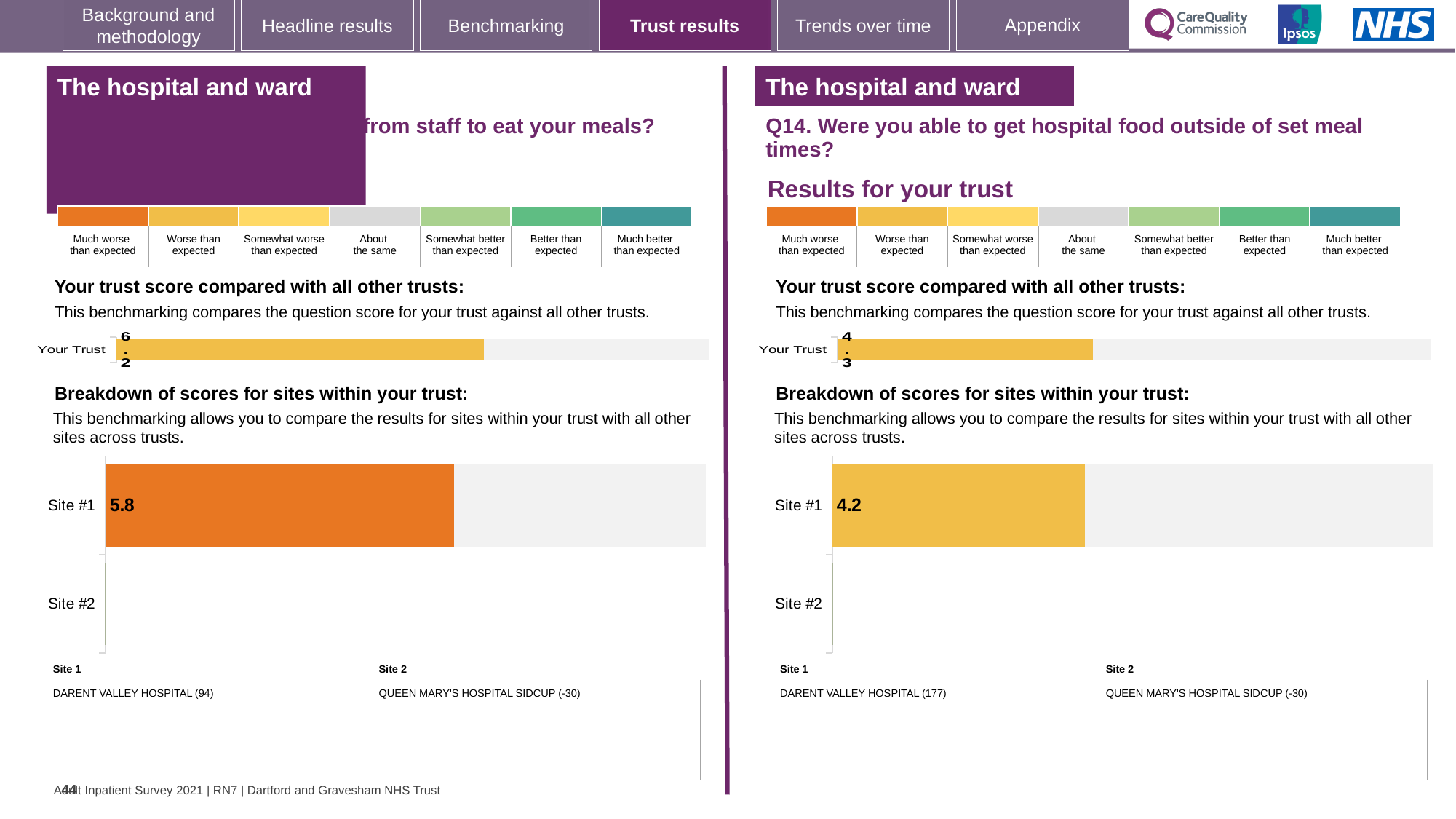
What is the difference between the left trust score and the left Site #1 score? 0.4 On the right half of the slide (Q14), what is the trust score shown in the 'Your trust score compared with all other trusts' bar chart? 4.3 In the left 'Breakdown of scores for sites within your trust' chart, what is the score for Site #1? 5.8 How many sites are listed in each 'Breakdown of scores for sites within your trust' chart? 2 On the left half of the slide, what is the trust score shown in the 'Your trust score compared with all other trusts' bar chart? 6.2 What is the difference between the right (Q14) trust score and the right Site #1 score? 0.1 In the left breakdown chart, which benchmark category does the colour of the Site #1 bar correspond to? Much worse than expected What is the difference between the Site #1 score in the left breakdown chart and the Site #1 score in the right breakdown chart? 1.6 Which is larger: the trust score on the left half of the slide or the trust score on the right half (Q14)? The left trust score (6.2) In the right breakdown chart (Q14), which benchmark category does the colour of the Site #1 bar correspond to? Worse than expected In the right 'Breakdown of scores for sites within your trust' chart (Q14), what is the score for Site #1? 4.2 What type of chart is used for the 'Breakdown of scores for sites within your trust' sections? Bar chart